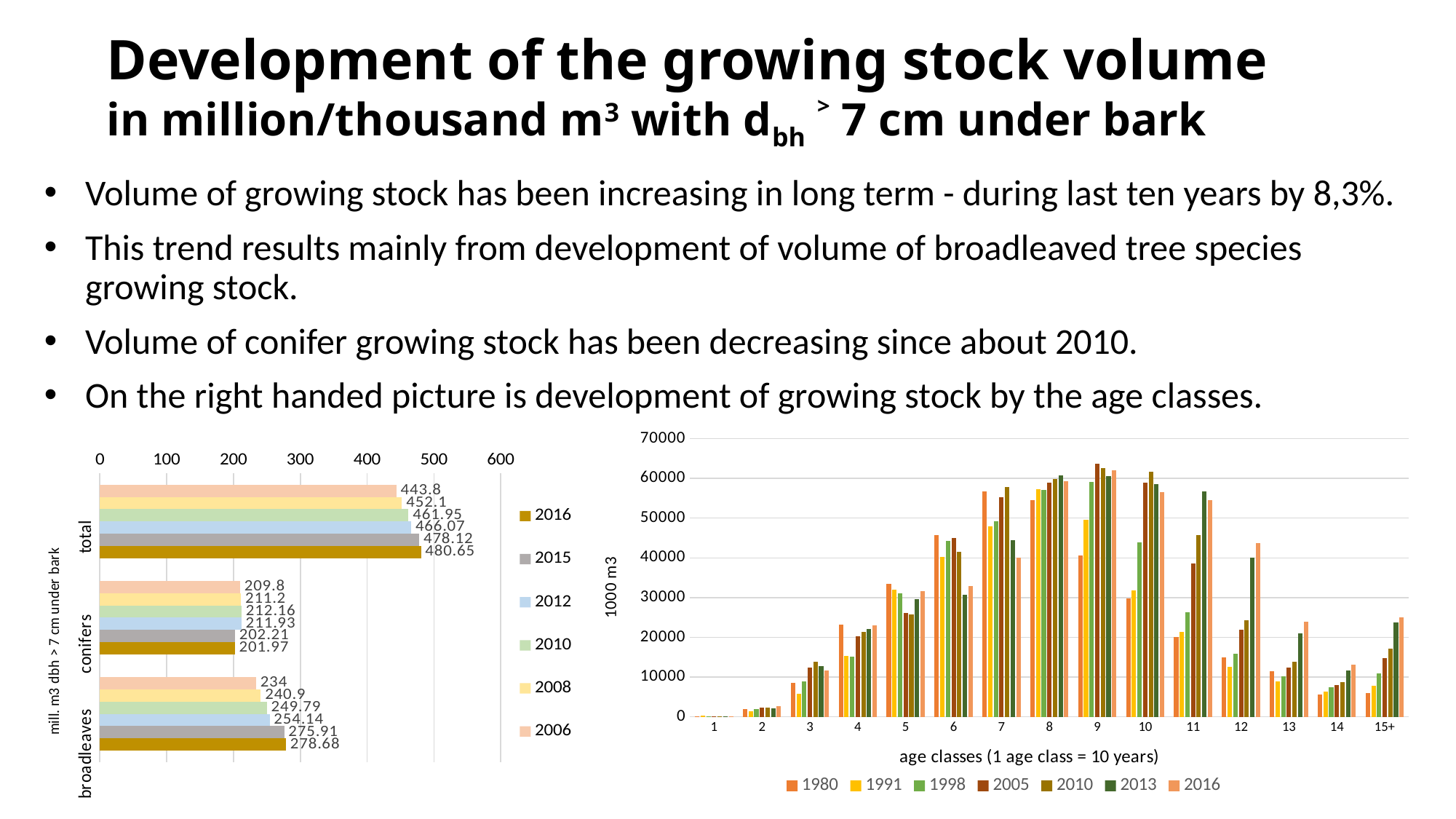
On the left chart, which year has the highest broadleaves value? 2016 On the left chart, what is the difference between the broadleaves values for 2016 and 2006? 44.68 On the left chart, what is the broadleaves value for 2012? 254.14 On the left chart, do the total values rise or fall from 2006 to 2016? rise On the left chart, which is larger: the conifers value for 2010 or for 2012? 2010 How many age classes are shown on the x axis of the right chart? 15 How many series does the legend of the right chart list? 7 On the left chart, which year has the lowest conifers value? 2016 On the right chart, is the value for 2005 in age class 9 greater or less than 60000? greater On the left chart, what is the conifers value for 2006? 209.8 What kind of chart is the right chart? bar chart On the left chart, what is the total growing stock volume for 2016? 480.65